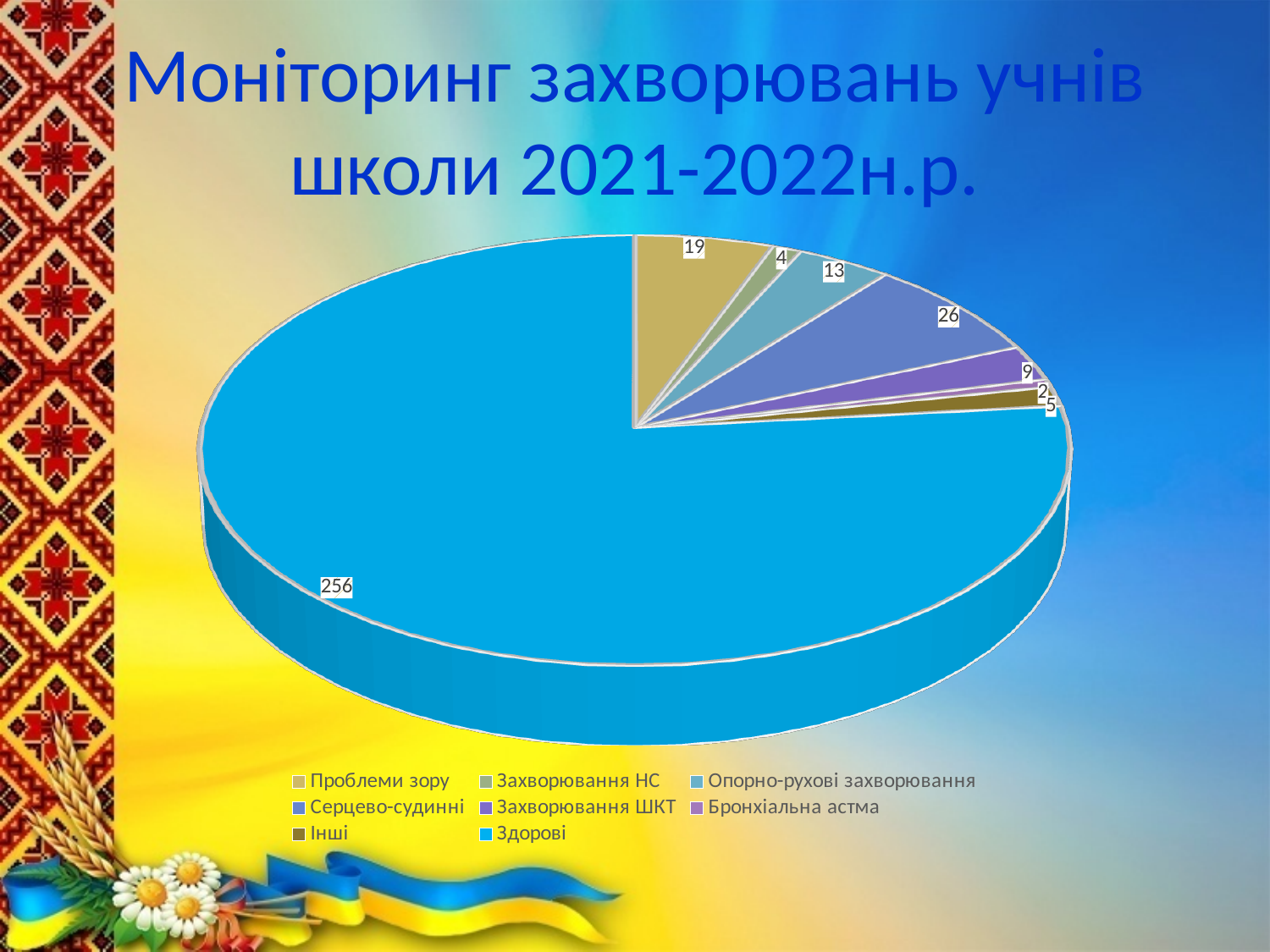
What is the title of the slide containing the chart? Моніторинг захворювань учнів школи 2021-2022н.р. What is the difference between the values for Серцево-судинні and Проблеми зору? 7 What is the value for Серцево-судинні? 26 What is the value for Проблеми зору? 19 Which category has the largest slice of the pie? Здорові What is the value for Здорові? 256 How many categories does the pie chart show? 8 Which is larger, the value for Захворювання ШКТ or the value for Інші? Захворювання ШКТ What is the value for Опорно-рухові захворювання? 13 Which category has the smallest slice of the pie? Бронхіальна астма What kind of chart is shown on the slide? Pie chart What is the total of all the values in the pie chart? 334